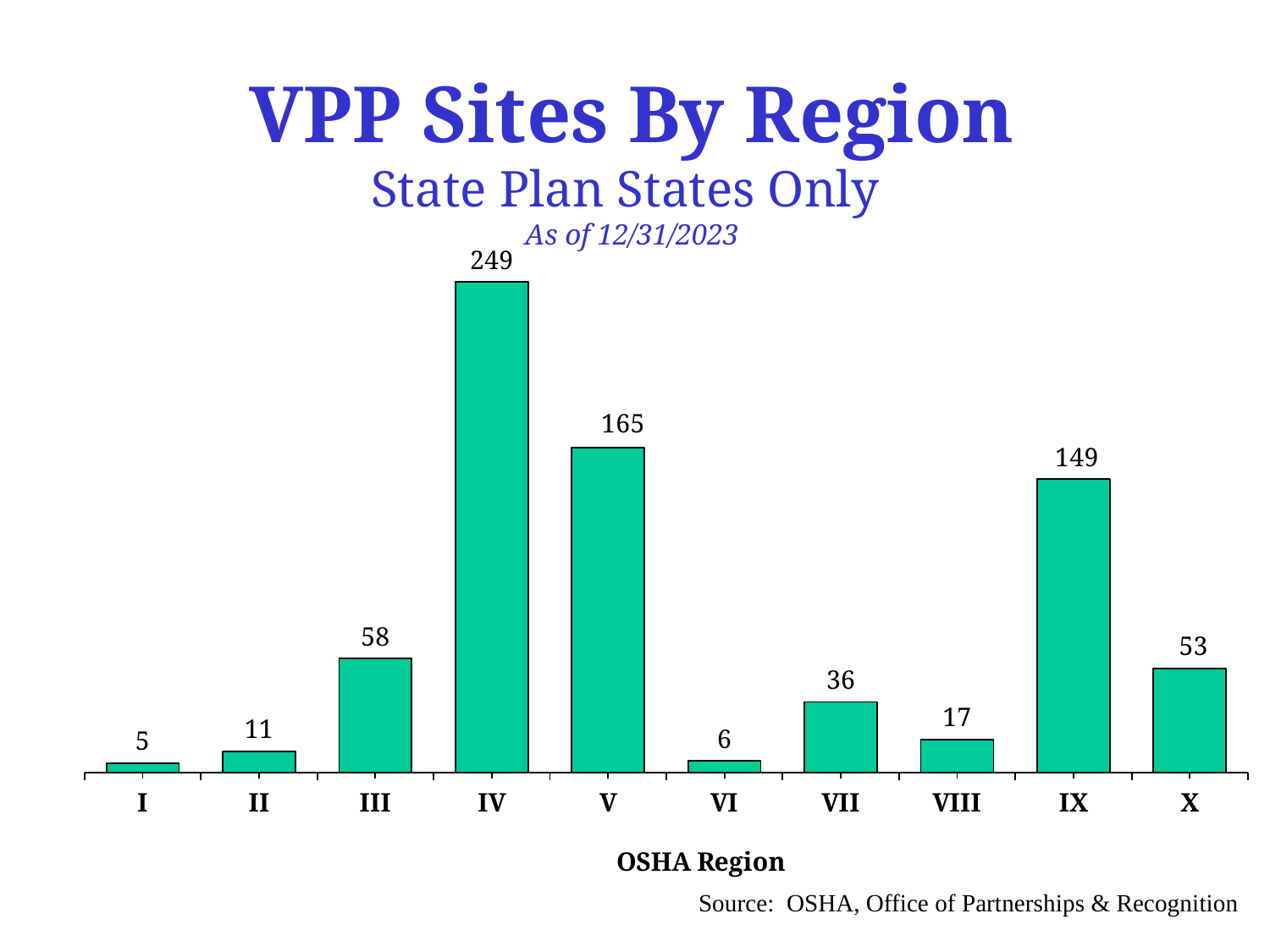
How many OSHA regions are shown on the x axis? 10 What is the value shown for Region IX? 149 Which has more VPP sites, Region V or Region IX? Region V Which has more VPP sites, Region III or Region X? Region III Which OSHA region has the highest number of VPP sites? IV How many more VPP sites does Region X have than Region VII? 17 What type of chart is shown on the slide? Bar chart How many VPP sites does Region VIII have? 17 Which OSHA region has the lowest number of VPP sites? I How many VPP sites are in OSHA Region IV? 249 What is the x-axis title of the chart? OSHA Region What is the difference between the values for Region IV and Region V? 84